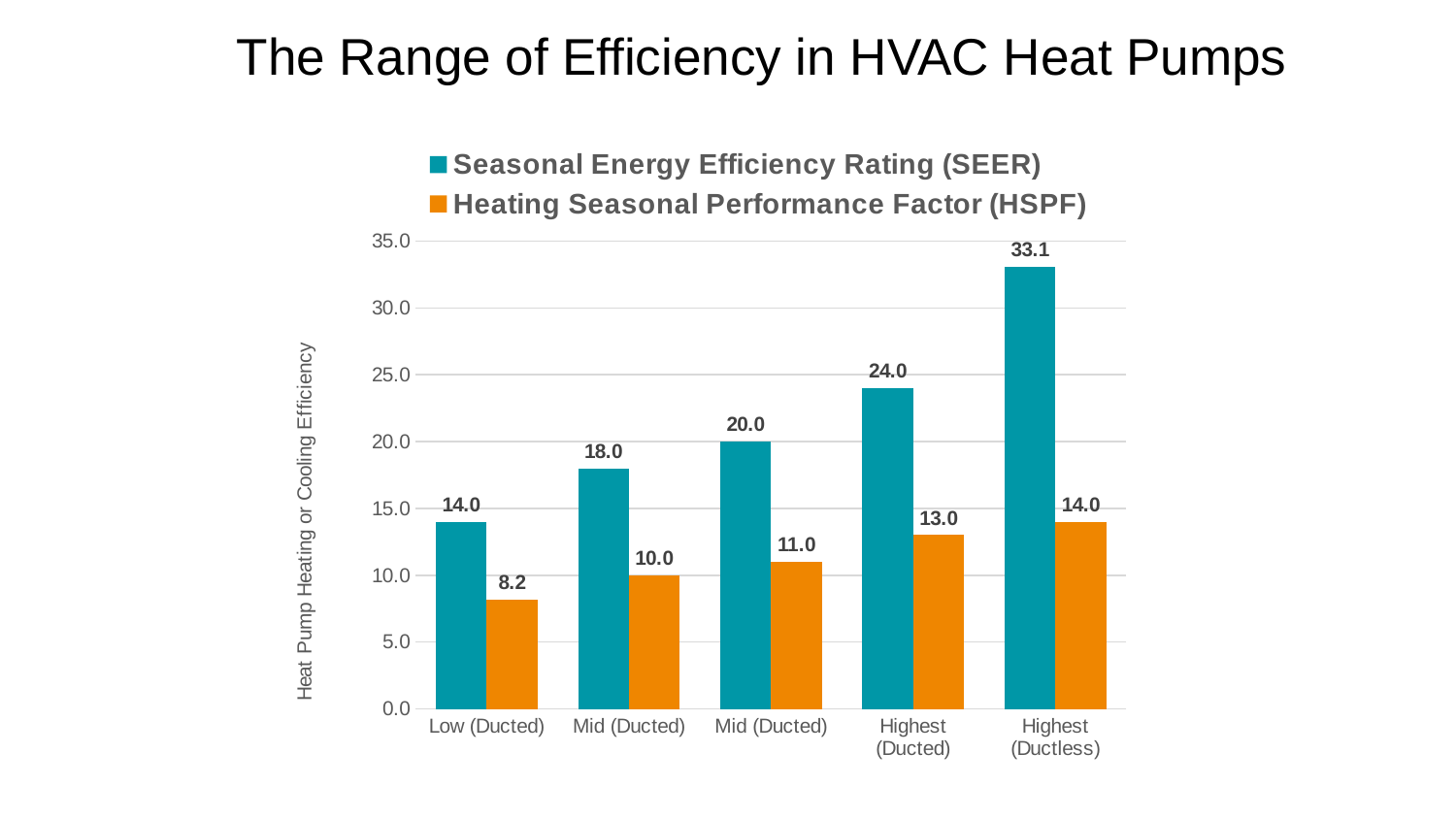
How many categories are shown on the x axis? 5 What is the SEER value for Highest (Ducted)? 24.0 How many series does the legend list? 2 What kind of chart is shown on the slide? Bar chart Which is larger: the SEER value for Low (Ducted) or the HSPF value for Highest (Ductless)? They are equal (14.0) What is the Heating Seasonal Performance Factor (HSPF) value for Low (Ducted)? 8.2 Which category has the lowest HSPF value? Low (Ducted) What is the HSPF value for Highest (Ducted)? 13.0 Which category has the highest SEER value? Highest (Ductless) What is the Seasonal Energy Efficiency Rating (SEER) value for Highest (Ductless)? 33.1 What is the difference between the SEER value and the HSPF value for Highest (Ductless)? 19.1 What is the difference between the SEER values for Highest (Ducted) and Low (Ducted)? 10.0